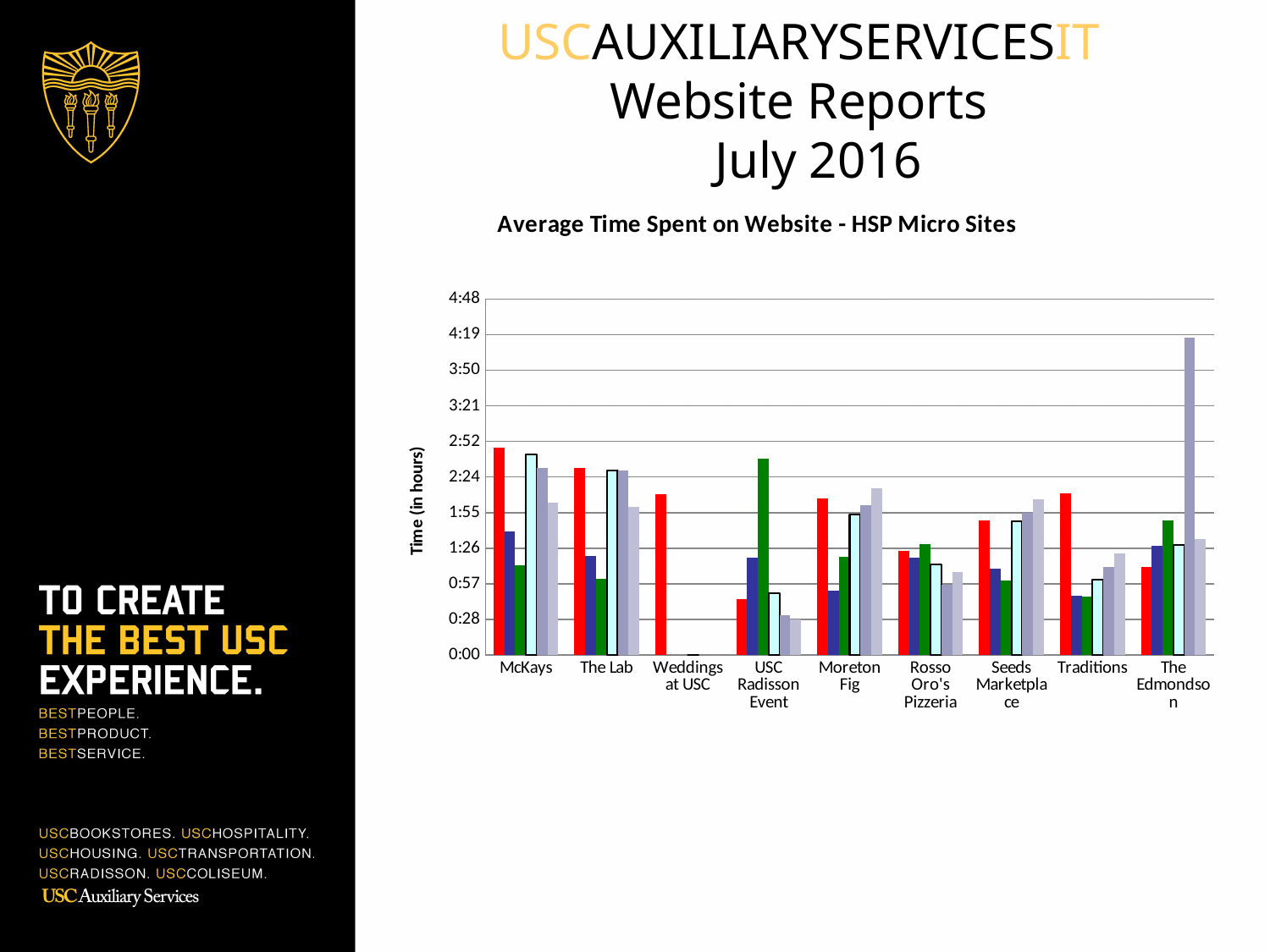
Which micro site has the tallest red bar? McKays What is the label on the vertical axis of the chart? Time (in hours) What kind of chart is shown on the slide? bar chart Is the red bar for Weddings at USC greater or less than 1:26? greater Which is larger: the red bar for McKays or the red bar for Traditions? McKays Which micro site has the shortest red bar? USC Radisson Event Is the tallest bar for The Edmondson greater or less than 3:50? greater Which micro site has the single tallest bar in the chart? The Edmondson How many micro sites (categories) are shown along the x axis? 9 Is the red bar for USC Radisson Event greater or less than 0:57? less What is the title of the chart? Average Time Spent on Website - HSP Micro Sites